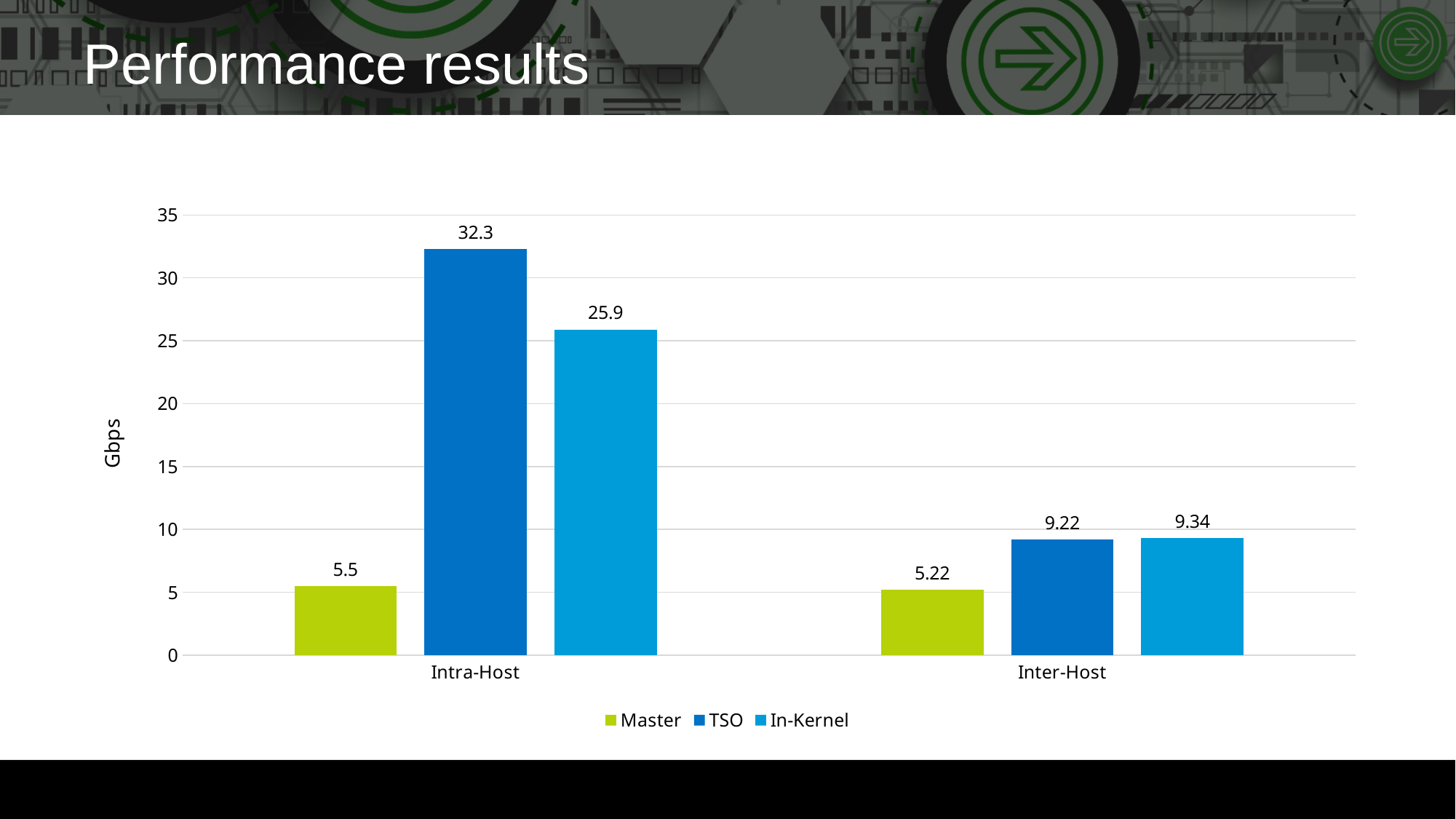
Which series has the highest value in the Intra-Host category? TSO What is the value for Master in the Inter-Host category? 5.22 Which is larger: the TSO value for Intra-Host or the TSO value for Inter-Host? Intra-Host What is the label of the y axis? Gbps What is the difference between the Master values for Intra-Host and Inter-Host? 0.28 How many series does the legend list? 3 What is the difference between the TSO and In-Kernel values in the Intra-Host category? 6.4 What is the value for In-Kernel in the Intra-Host category? 25.9 How many categories are shown on the x axis? 2 What is the value for TSO in the Intra-Host category? 32.3 What kind of chart is shown on the slide? Bar chart Which series has the lowest value in the Inter-Host category? Master